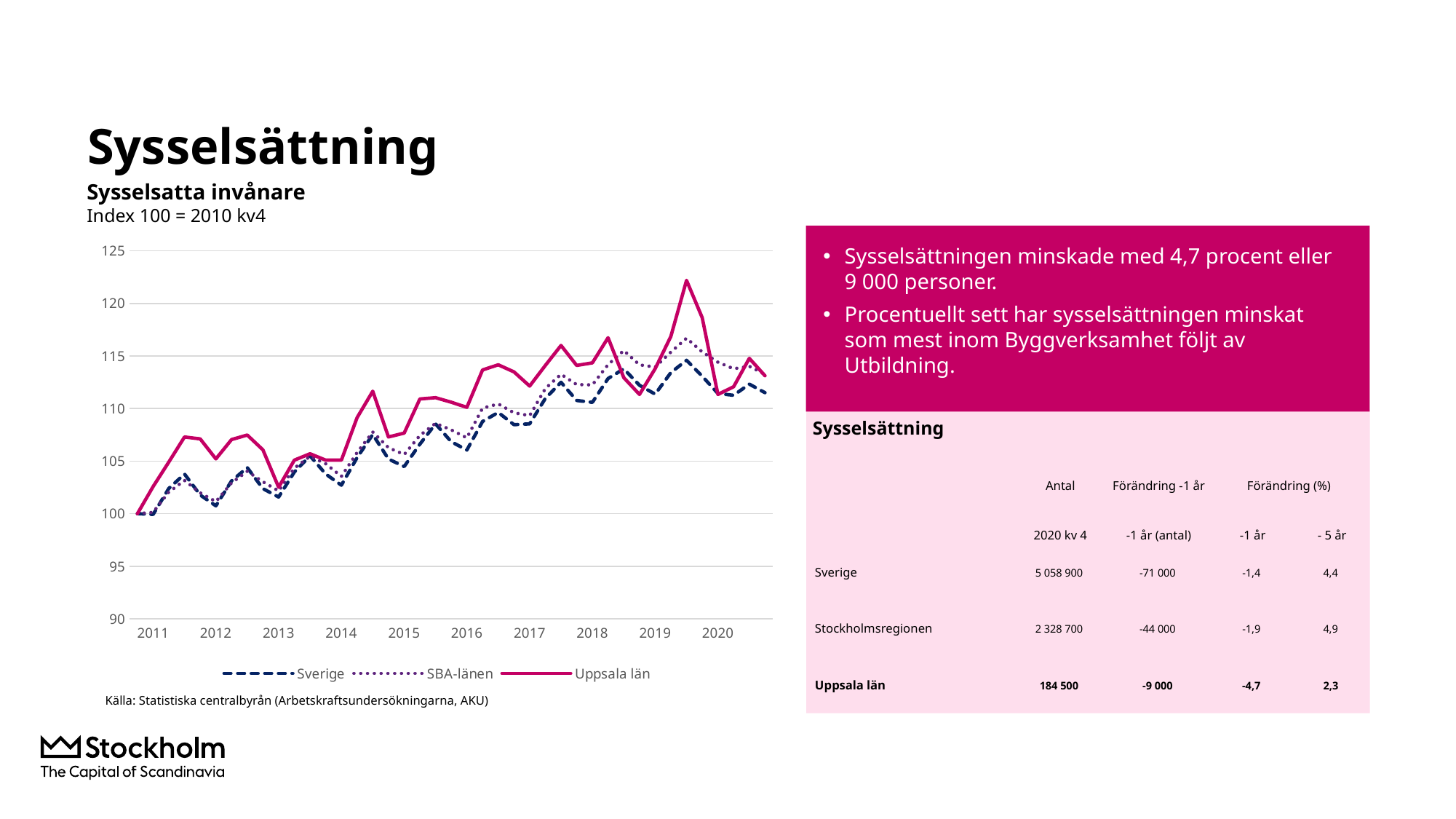
Is the value for Sverige during 2011 greater or less than 105? less Is the value for Uppsala län at the end of 2020 greater or less than 110? greater Which series are listed in the chart legend? Sverige, SBA-länen, Uppsala län What is the subtitle of the chart above the plot area? Sysselsatta invånare Which series is drawn as a solid line on the chart? Uppsala län Which series reaches the highest value on the chart? Uppsala län At the 2019 peak, which series is higher: Uppsala län or Sverige? Uppsala län How many series does the chart legend list? 3 Do the index values for Sverige generally rise or fall from 2011 to 2020? rise Is the peak value for Uppsala län in 2019 greater or less than 120? greater What kind of chart is shown on the slide? line chart How many year labels are shown on the x axis of the chart? 10